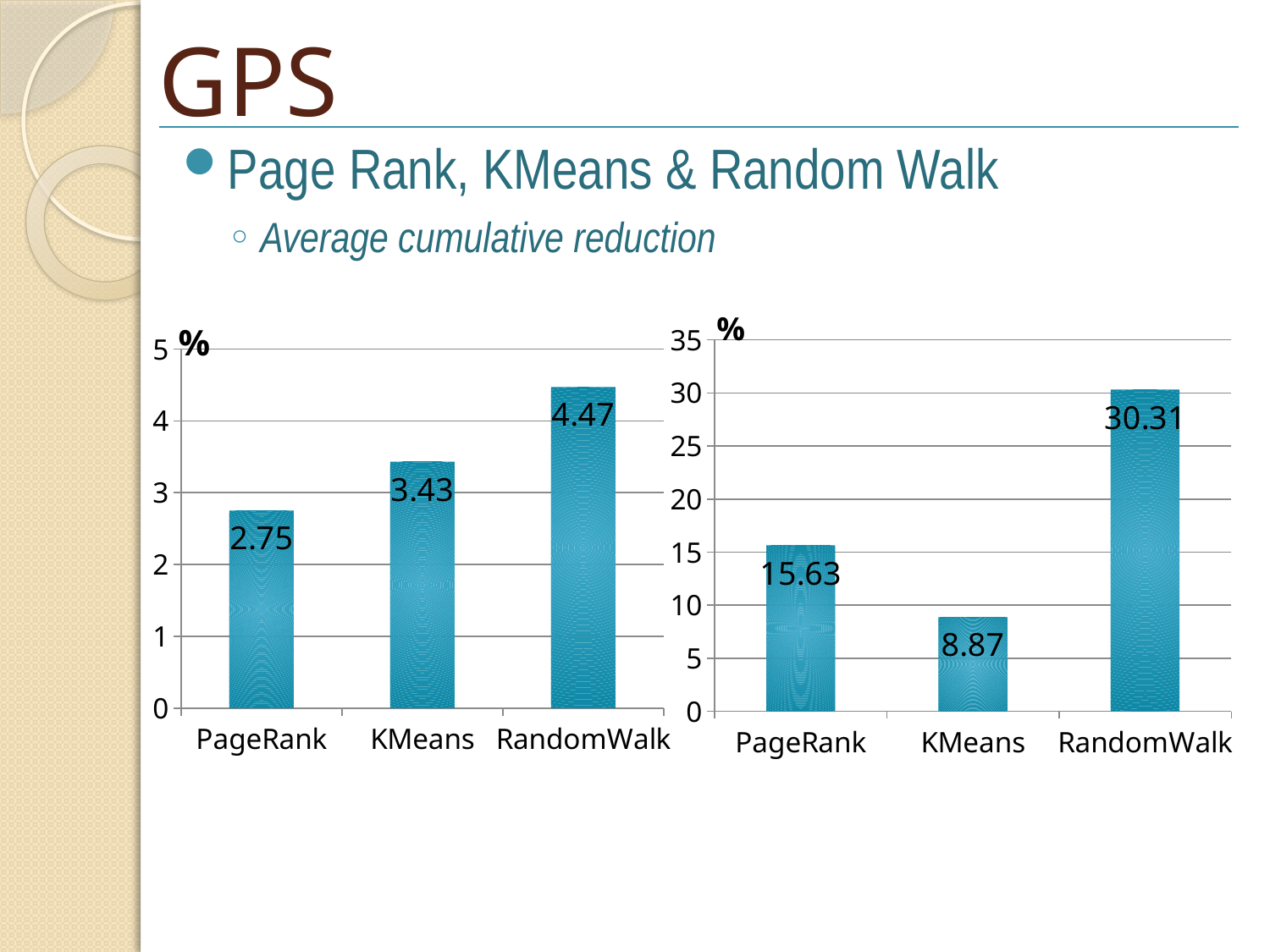
In the right chart, what is the value for KMeans? 8.87 In the right chart, which category has the lowest value? KMeans In the left chart, which category has the highest value? RandomWalk What kind of chart is the right chart? bar chart In the right chart, which is larger, the value for PageRank or the value for KMeans? PageRank In the left chart, what is the value for PageRank? 2.75 In the left chart, what is the value for KMeans? 3.43 In the right chart, what is the value for RandomWalk? 30.31 How many categories are shown in the left chart? 3 In the right chart, what is the difference between the values for RandomWalk and PageRank? 14.68 In the left chart, what is the difference between the values for RandomWalk and KMeans? 1.04 In the left chart, do the values rise or fall from PageRank to RandomWalk? rise